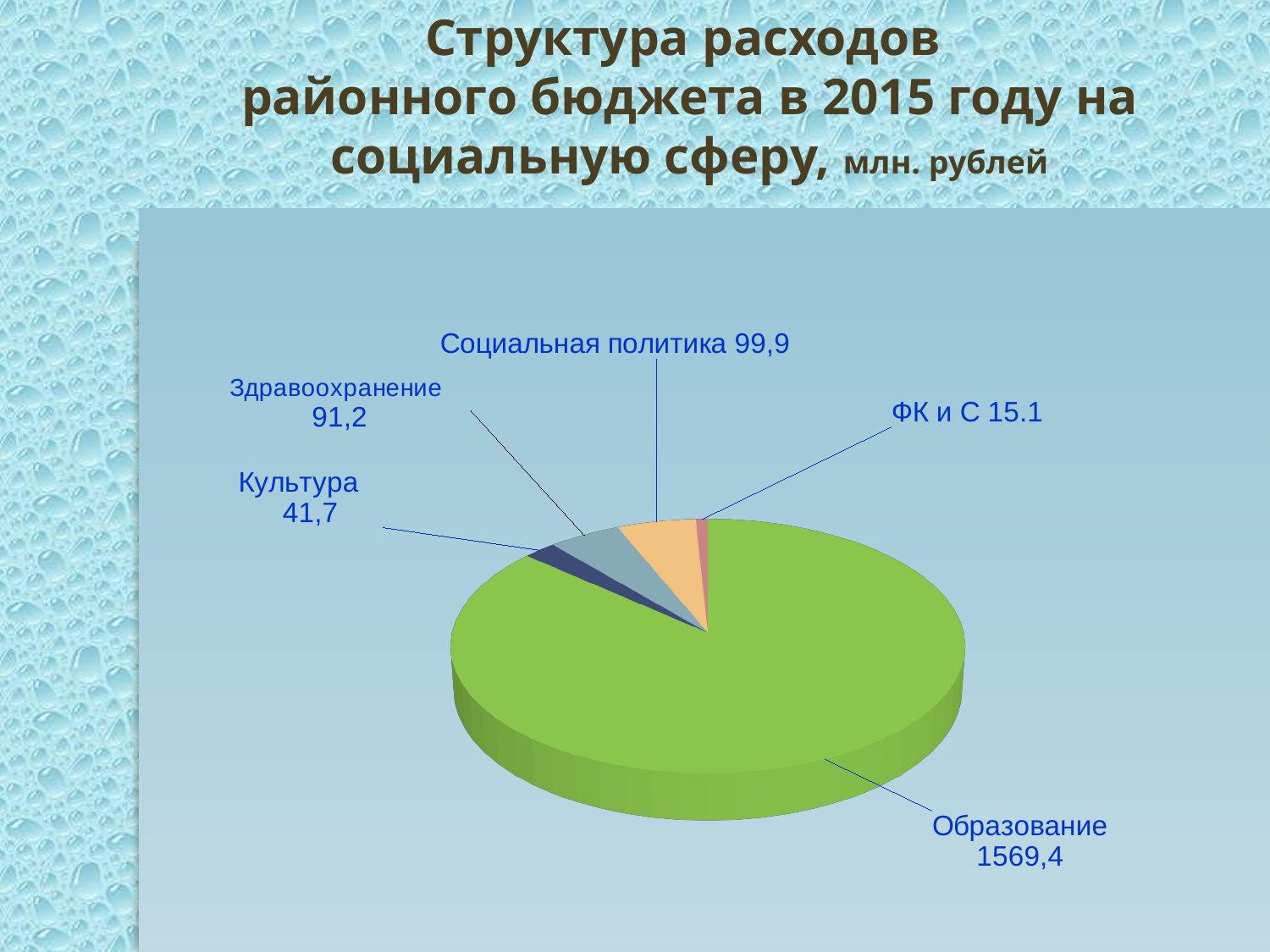
What is the value for Здравоохранение? 91,2 What is the value for Социальная политика? 99,9 How many categories are shown in the pie chart? 5 What is the difference between the values for Здравоохранение and Культура? 49,5 Which is larger, Социальная политика or Здравоохранение? Социальная политика What is the value for Культура? 41,7 What unit of measurement is stated in the chart title? млн. рублей What is the value for Образование? 1569,4 Which category has the largest slice of the pie? Образование What type of chart is shown on the slide? Pie chart Which category has the smallest slice of the pie? ФК и С What is the value for ФК и С? 15.1